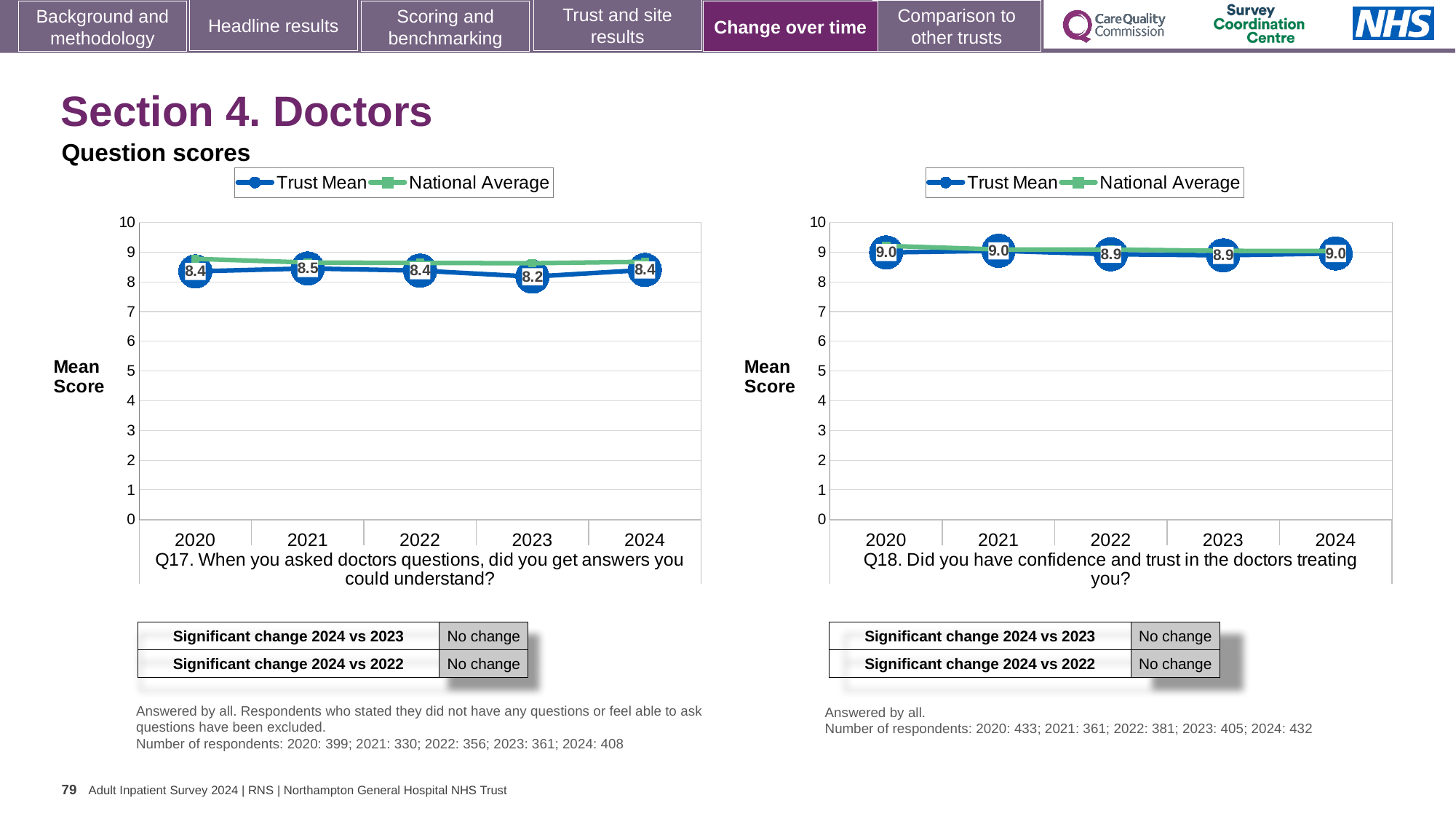
In the Q17 chart, which year has the lowest Trust Mean score? 2023 In the Q18 chart, what is the Trust Mean score for 2022? 8.9 In the Q17 chart, what is the Trust Mean score for 2021? 8.5 How many series does the legend of the Q18 chart list? 2 In the Q18 chart, what is the difference between the Trust Mean scores for 2020 and 2023? 0.1 How many years are plotted on the x axis of the Q17 chart? 5 In the Q18 chart, is the National Average value for 2020 greater or less than 8? greater In the Q18 chart, what is the Trust Mean score for 2024? 9.0 In the Q17 chart, which year has the highest Trust Mean score? 2021 In the Q17 chart, is the Trust Mean score higher in 2021 or in 2023? 2021 In the Q17 chart, what is the Trust Mean score for 2023? 8.2 In the Q17 chart, what is the difference between the Trust Mean scores for 2021 and 2023? 0.3